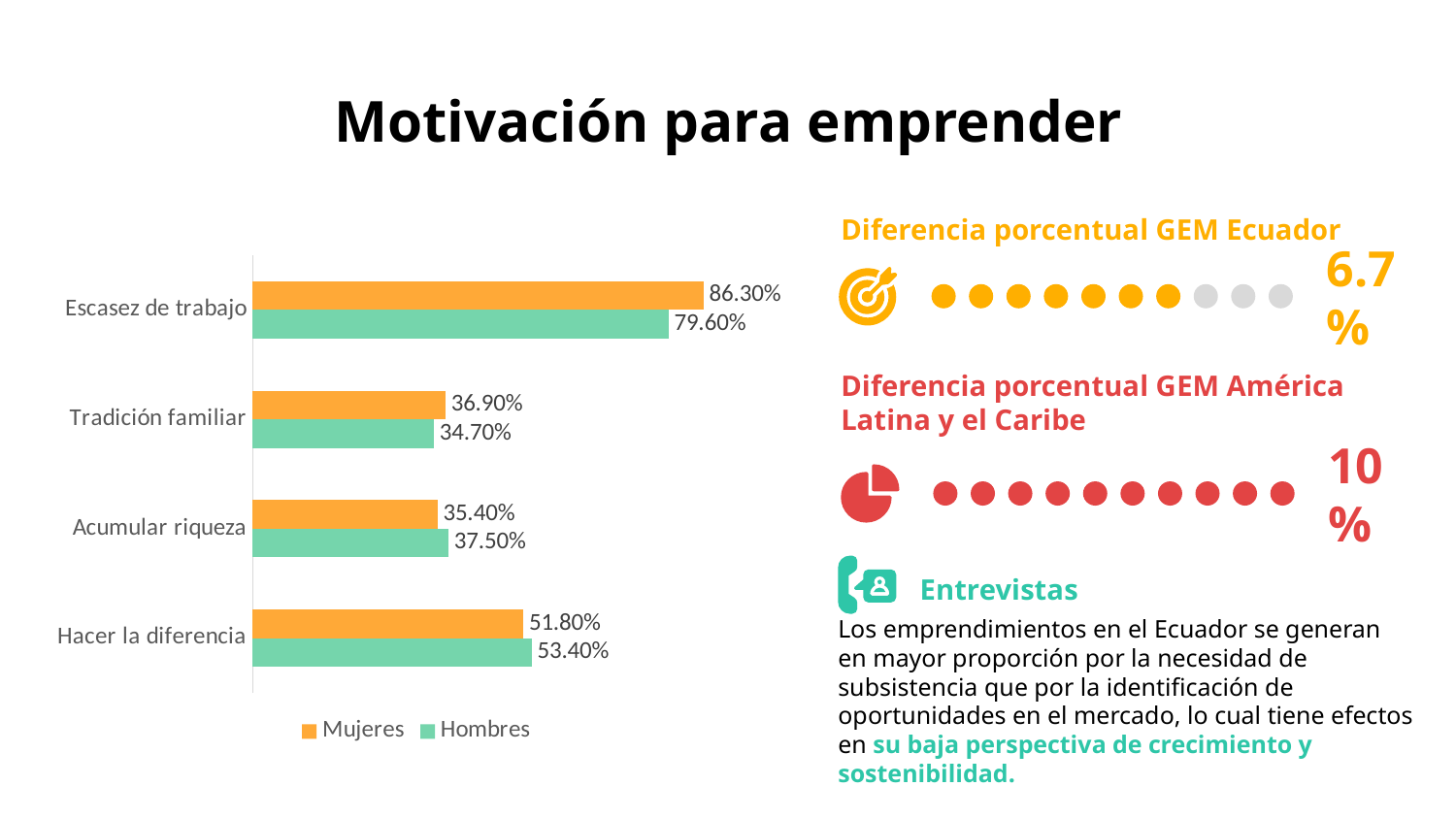
How many series does the legend list? 2 What kind of chart is shown on the slide? Bar chart Which category has the highest value for Mujeres? Escasez de trabajo What is the difference between the Mujeres and Hombres values for Escasez de trabajo? 6.70% Which is larger for Acumular riqueza, the Mujeres value or the Hombres value? Hombres What is the value for Hombres in the Hacer la diferencia category? 53.40% How many categories are shown in the bar chart? 4 Which category has the lowest value for Hombres? Tradición familiar What is the value for Mujeres in the Escasez de trabajo category? 86.30% What is the value for Hombres in the Tradición familiar category? 34.70% Which colour represents the Mujeres series in the chart? Orange What is the difference between the Hombres and Mujeres values for Hacer la diferencia? 1.60%